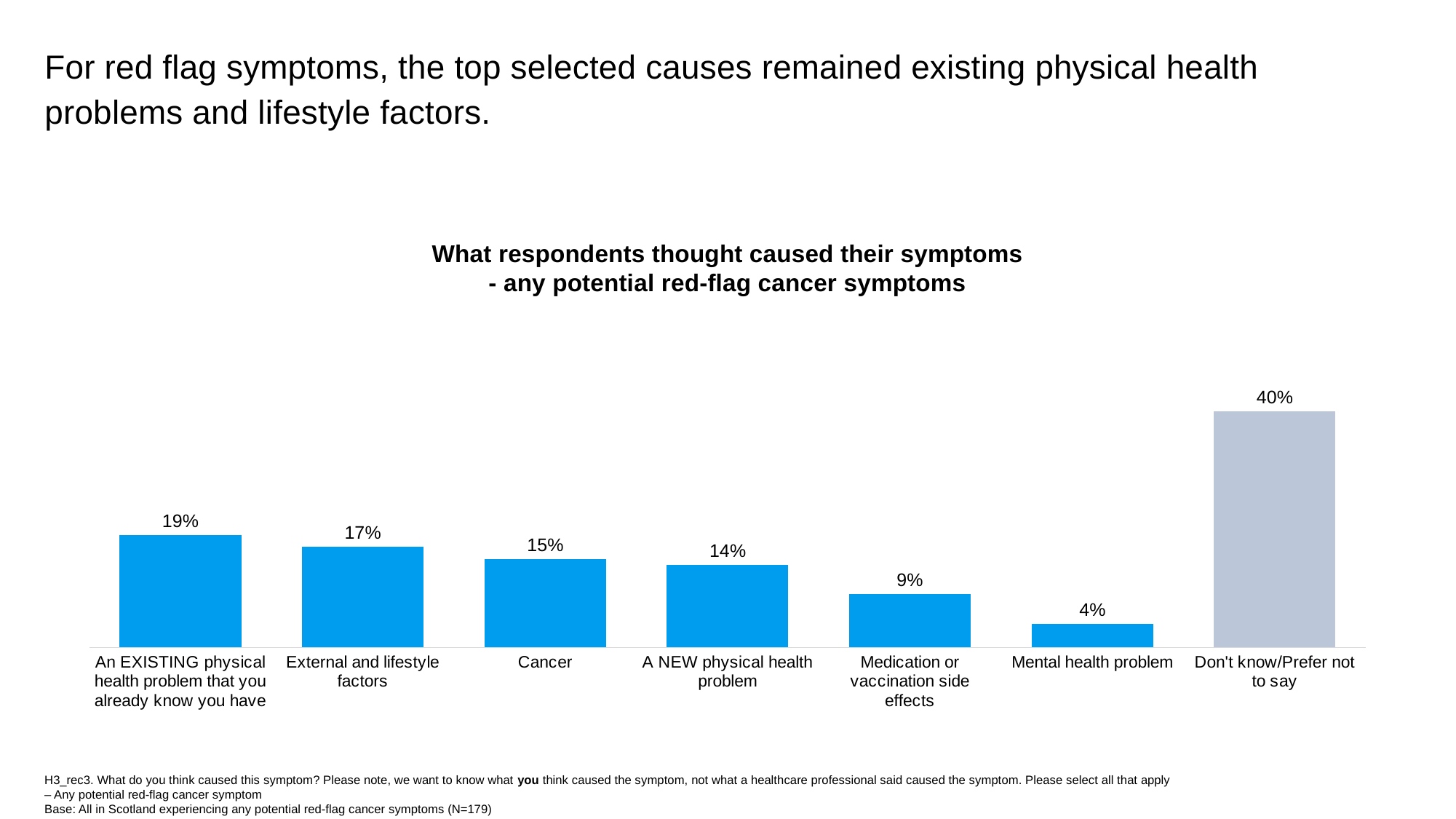
What is the value shown for Cancer? 15% What is the value for Don't know/Prefer not to say? 40% What type of chart is shown on the slide? Bar chart How many categories are shown in the chart? 7 What is the difference between the values for External and lifestyle factors and A NEW physical health problem? 3 percentage points What percentage is shown for Medication or vaccination side effects? 9% Which bar is shown in a different colour (grey) from the others? Don't know/Prefer not to say Which category has the lowest value in the chart? Mental health problem Which category has the highest value in the chart? Don't know/Prefer not to say What percentage of respondents thought an existing physical health problem that they already know they have caused their symptoms? 19% Which is larger: the value for Cancer or the value for Medication or vaccination side effects? Cancer What is the title of the chart? What respondents thought caused their symptoms - any potential red-flag cancer symptoms